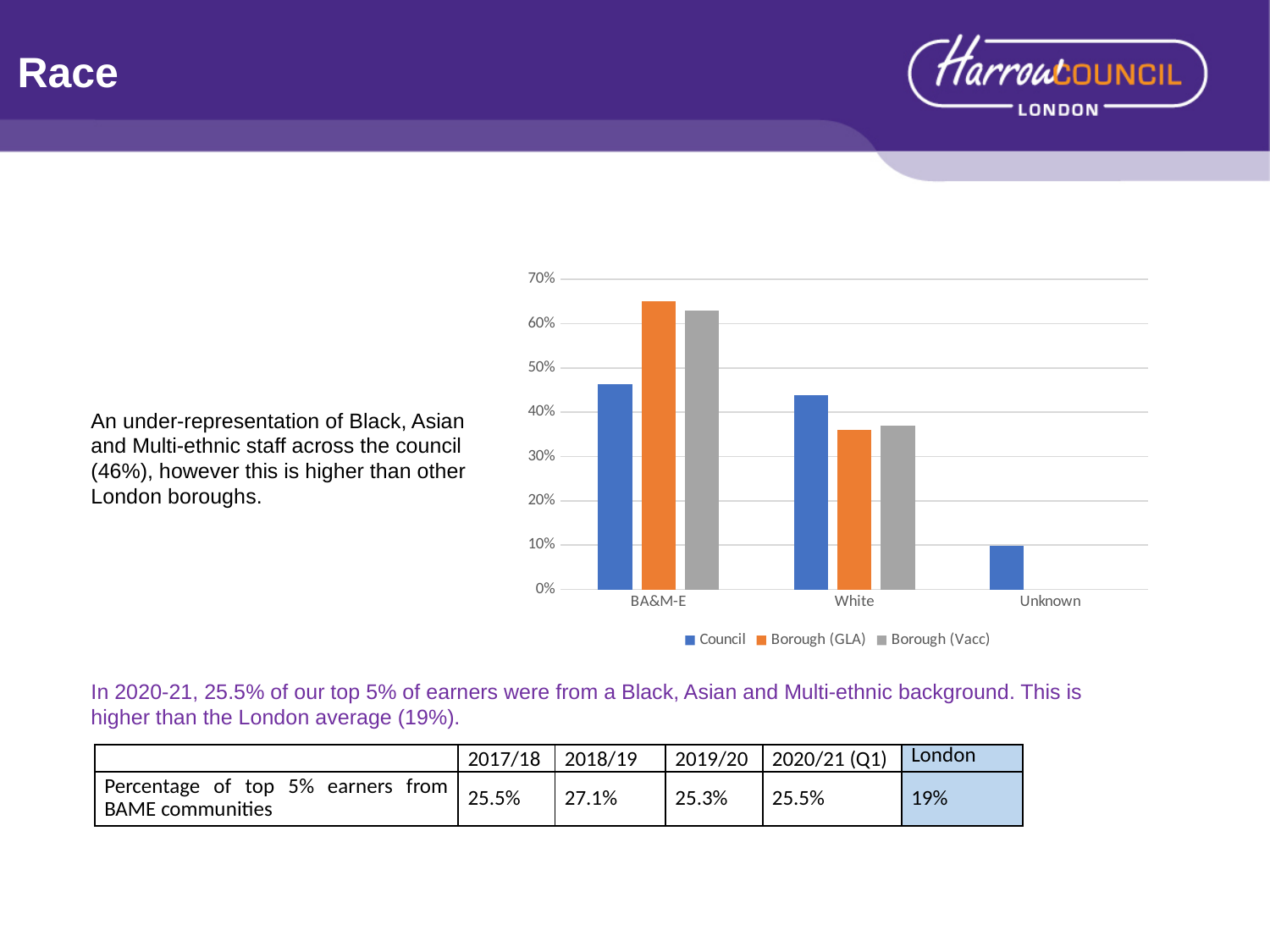
Which category has the lowest Council value? Unknown Do the Council values rise or fall moving from BA&M-E to Unknown along the x axis? fall For BA&M-E, which is larger: the Council value or the Borough (GLA) value? Borough (GLA) Which category has the highest Borough (GLA) value? BA&M-E Is the Borough (GLA) value for BA&M-E greater or less than 60%? greater How many categories are shown on the x axis of the chart? 3 For White, which is larger: the Council value or the Borough (GLA) value? Council What kind of chart is shown on the slide? bar chart Which category has a bar for only one series? Unknown How many series does the chart legend list? 3 Is the Council value for BA&M-E greater or less than 40%? greater Is the Council value for Unknown greater or less than 20%? less